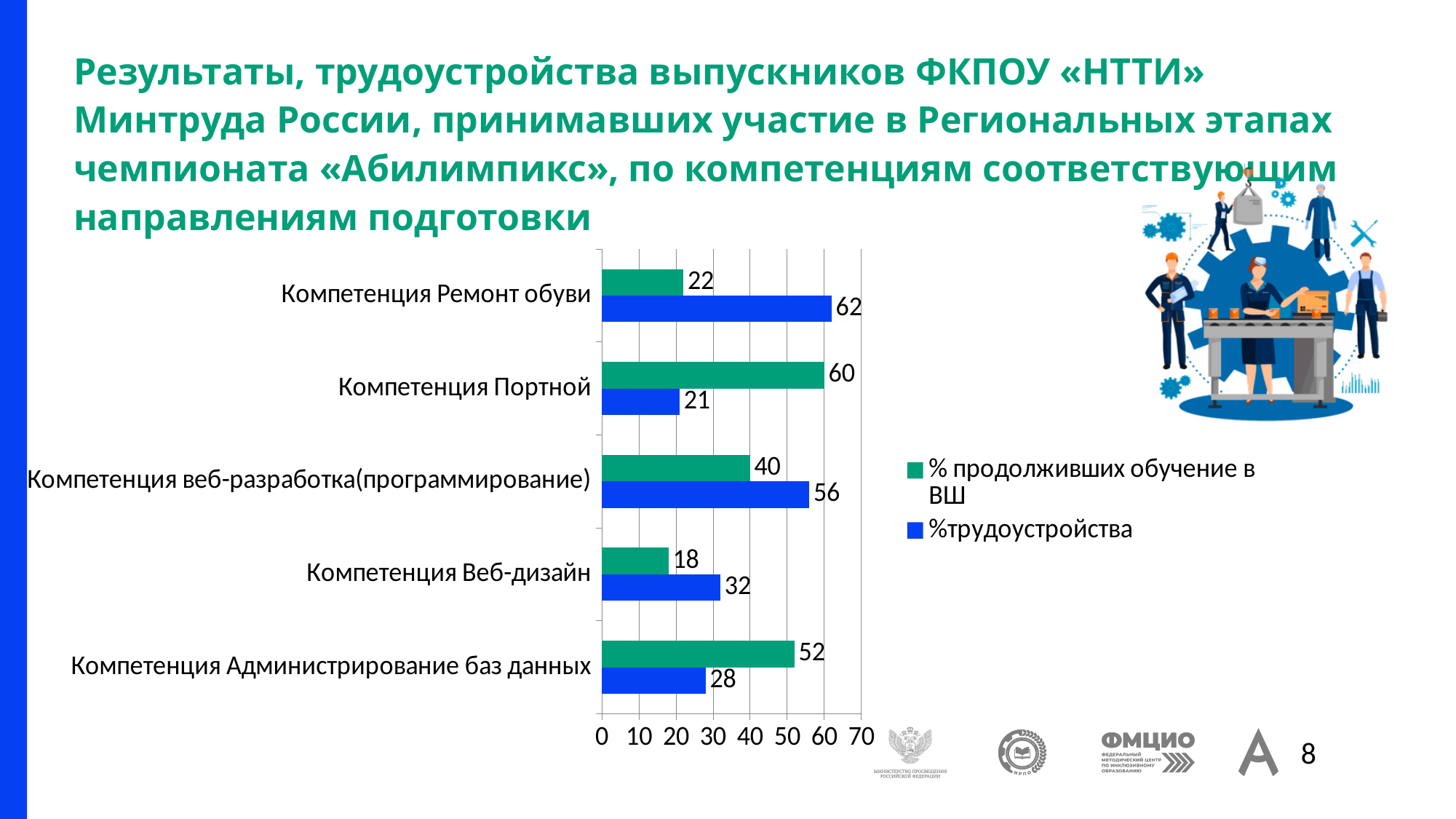
Is the %трудоустройства value for Компетенция Портной greater or less than 30? less What is the %трудоустройства value for Компетенция Веб-дизайн? 32 Which colour represents the %трудоустройства series in the chart? blue What is the %трудоустройства value for Компетенция Ремонт обуви? 62 How many series does the chart legend list? 2 What is the difference between the %трудоустройства and % продолживших обучение в ВШ values for Компетенция веб-разработка(программирование)? 16 Which competency has the highest %трудоустройства value? Компетенция Ремонт обуви For Компетенция Администрирование баз данных, which is larger: % продолживших обучение в ВШ or %трудоустройства? % продолживших обучение в ВШ What type of chart is shown on the slide? bar chart What is the % продолживших обучение в ВШ value for Компетенция Портной? 60 Which competency has the lowest % продолживших обучение в ВШ value? Компетенция Веб-дизайн How many competencies (categories) are shown in the chart? 5